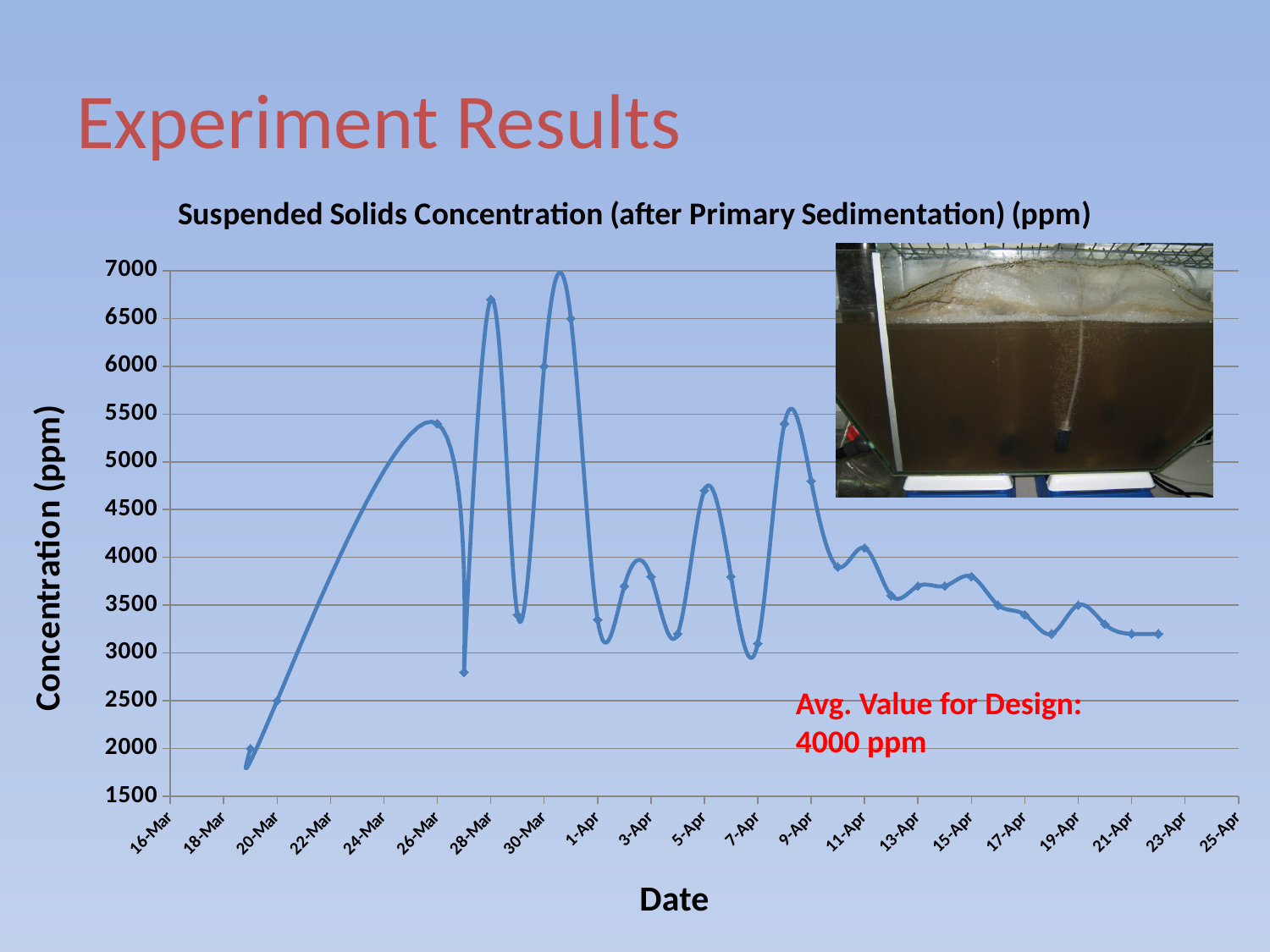
What is the title of the chart? Suspended Solids Concentration (after Primary Sedimentation) (ppm) Is the highest concentration plotted on the chart greater or less than 6500? greater Is the concentration on 26-Mar greater or less than 5000? greater What average value for design is stated on the chart? 4000 ppm What kind of chart is shown on the slide? Line chart Is the concentration on 5-Apr greater or less than 4500? greater Between 19-Mar and 26-Mar, does the concentration rise or fall? rise From 9-Apr to 23-Apr, does the concentration generally rise or fall? fall